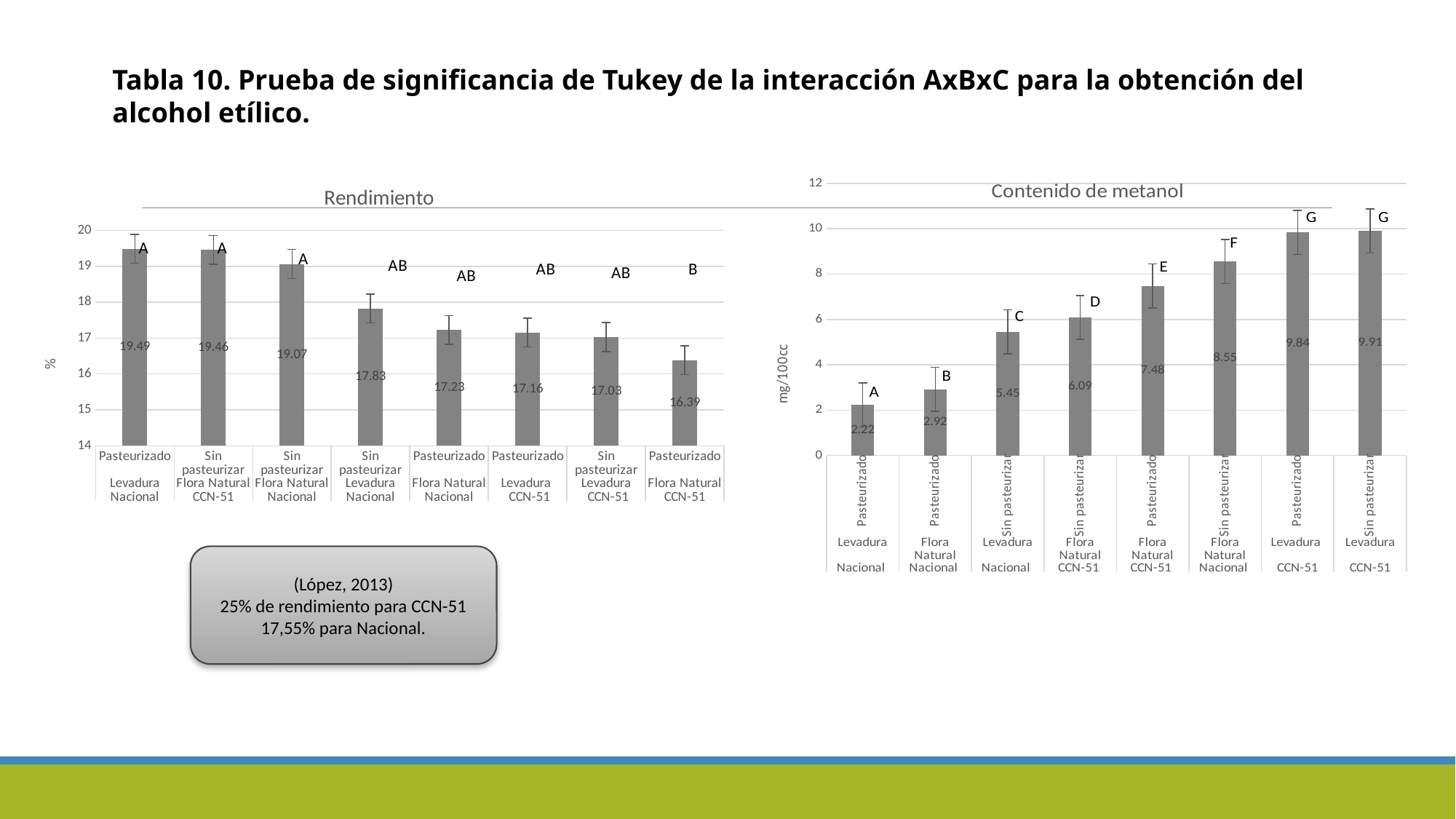
What kind of chart is the Contenido de metanol chart? bar chart In the Contenido de metanol chart, which category has the lowest value? Pasteurizado, Levadura, Nacional In the Rendimiento chart, what is the difference between the values for Pasteurizado, Levadura, Nacional and Pasteurizado, Flora Natural, CCN-51? 3.10 In the Contenido de metanol chart, do the values rise or fall from left to right along the x axis? rise In the Contenido de metanol chart, what is the value for Sin pasteurizar, Flora Natural, Nacional? 8.55 In the Rendimiento chart, which category has the lowest value? Pasteurizado, Flora Natural, CCN-51 In the Rendimiento chart, what is the value for Pasteurizado, Flora Natural, CCN-51? 16.39 In the Rendimiento chart, how many bars are plotted? 8 In the Contenido de metanol chart, which is larger: the value for Sin pasteurizar, Levadura, Nacional or the value for Pasteurizado, Flora Natural, CCN-51? Pasteurizado, Flora Natural, CCN-51 In the Contenido de metanol chart, what is the value for Pasteurizado, Levadura, Nacional? 2.22 In the Contenido de metanol chart, what is the difference between the values for Pasteurizado, Levadura, CCN-51 and Pasteurizado, Flora Natural, Nacional? 6.92 In the Rendimiento chart, what is the value for Sin pasteurizar, Levadura, Nacional? 17.83